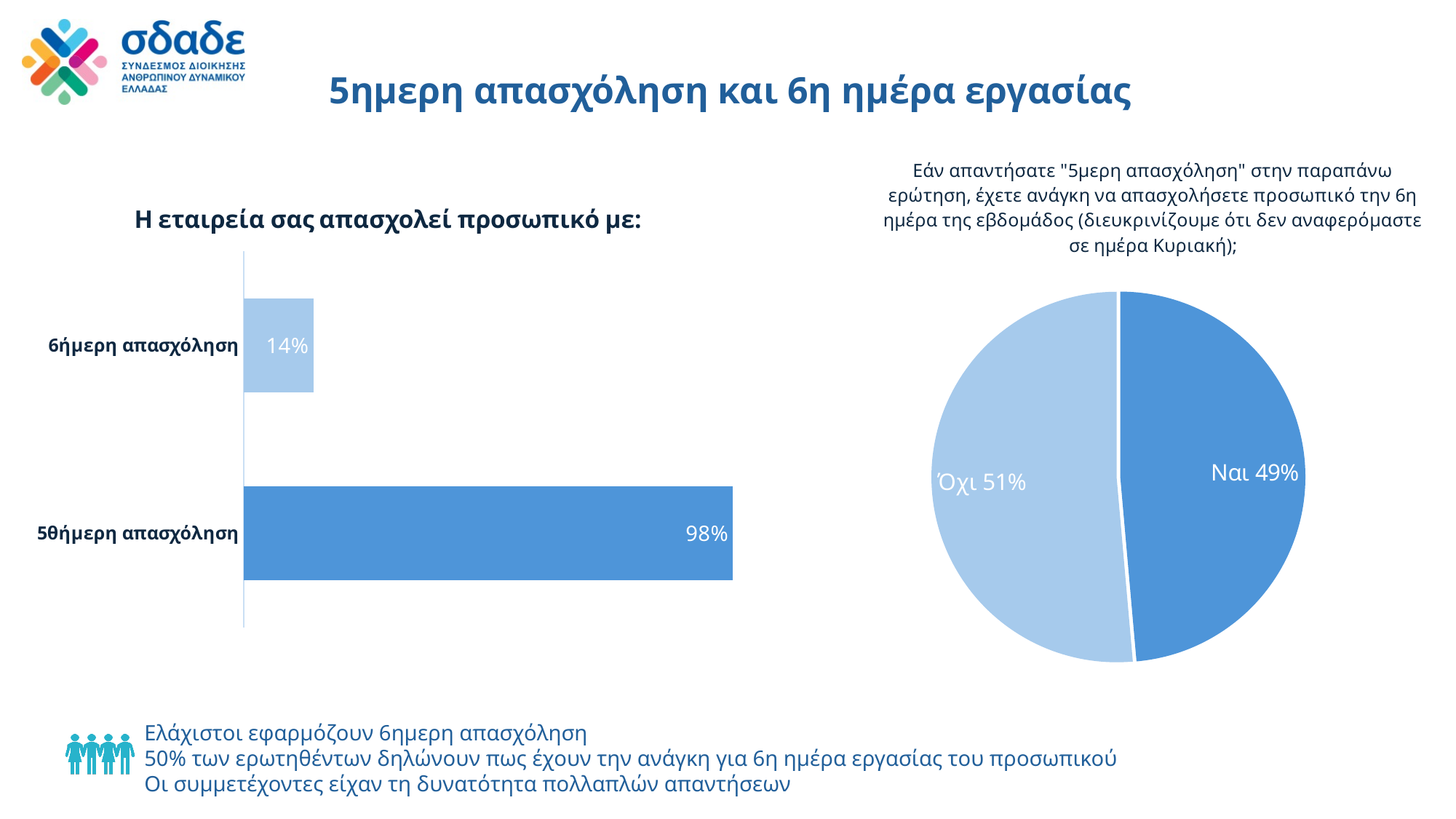
In the pie chart on the right, what share does Ναι have? 49% In the bar chart on the left, which category has the highest value? 5θήμερη απασχόληση In the bar chart on the left, what is the difference between the values for 5θήμερη απασχόληση and 6ήμερη απασχόληση? 84% In the bar chart on the left, what is the value for 6ήμερη απασχόληση? 14% In the pie chart on the right, how many slices are there? 2 In the pie chart on the right, what share does Όχι have? 51% In the bar chart on the left, which category has the lowest value? 6ήμερη απασχόληση In the bar chart on the left, what is the value for 5θήμερη απασχόληση? 98% What kind of chart is the chart on the left? bar chart In the bar chart on the left, how many categories are shown? 2 In the pie chart on the right, which slice is larger, Ναι or Όχι? Όχι What kind of chart is the chart on the right? pie chart